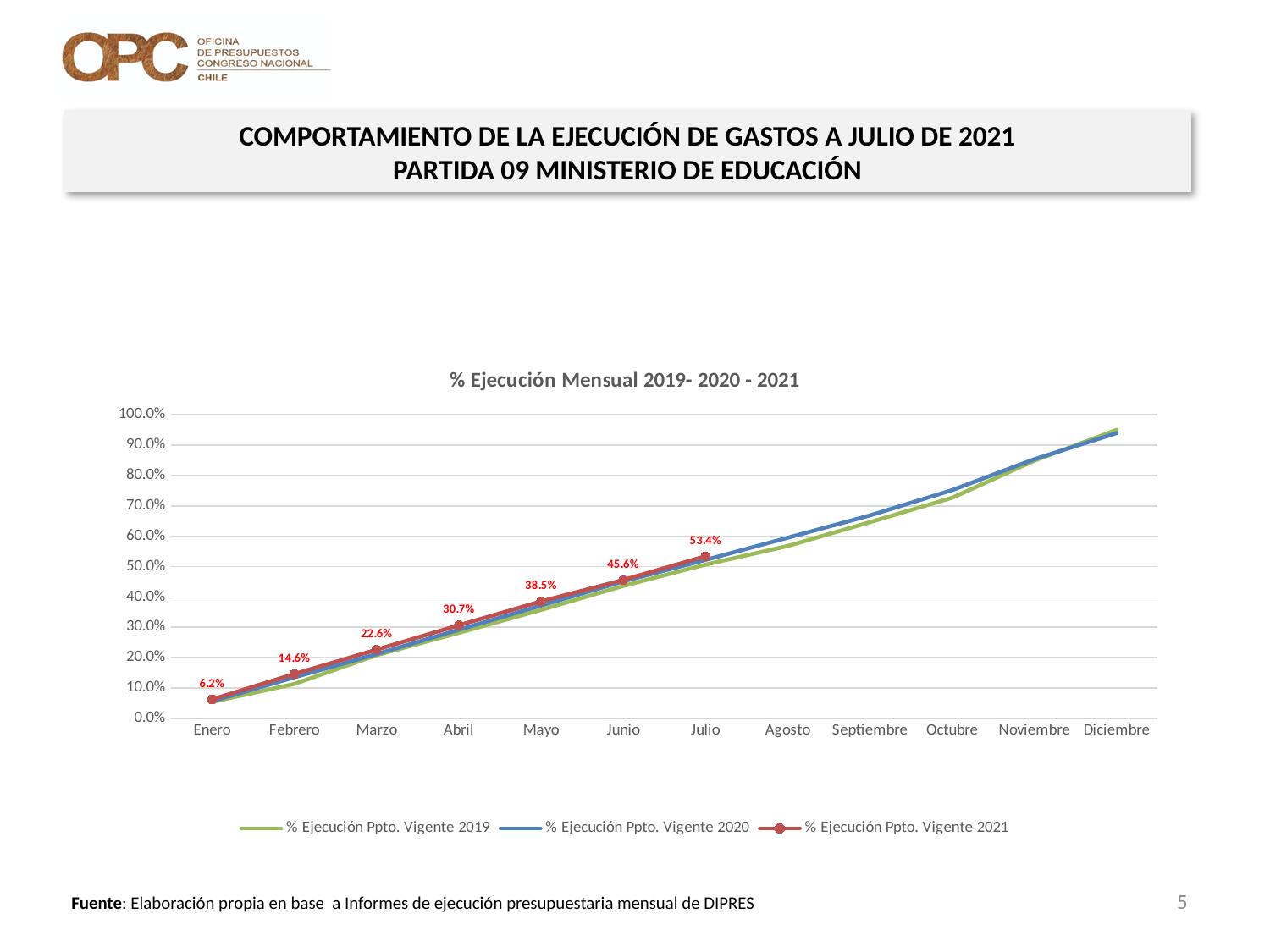
What is the value for % Ejecución Ppto. Vigente 2021 in Enero? 6.2% What is the difference between the 2021 values for Julio and Junio? 7.8% What is the value for % Ejecución Ppto. Vigente 2021 in Julio? 53.4% Is the value for % Ejecución Ppto. Vigente 2019 in Agosto greater or less than 60%? less Among the labeled 2021 values, which month has the highest value? Julio What is the difference between the 2021 values for Marzo and Febrero? 8.0% Is the value for % Ejecución Ppto. Vigente 2020 in Octubre greater or less than 70%? greater Do the values for % Ejecución Ppto. Vigente 2019 rise or fall from Enero to Diciembre? rise How many months are shown on the x axis? 12 How many series does the legend list? 3 What is the value for % Ejecución Ppto. Vigente 2021 in Abril? 30.7% Among the labeled 2021 values, which month has the lowest value? Enero